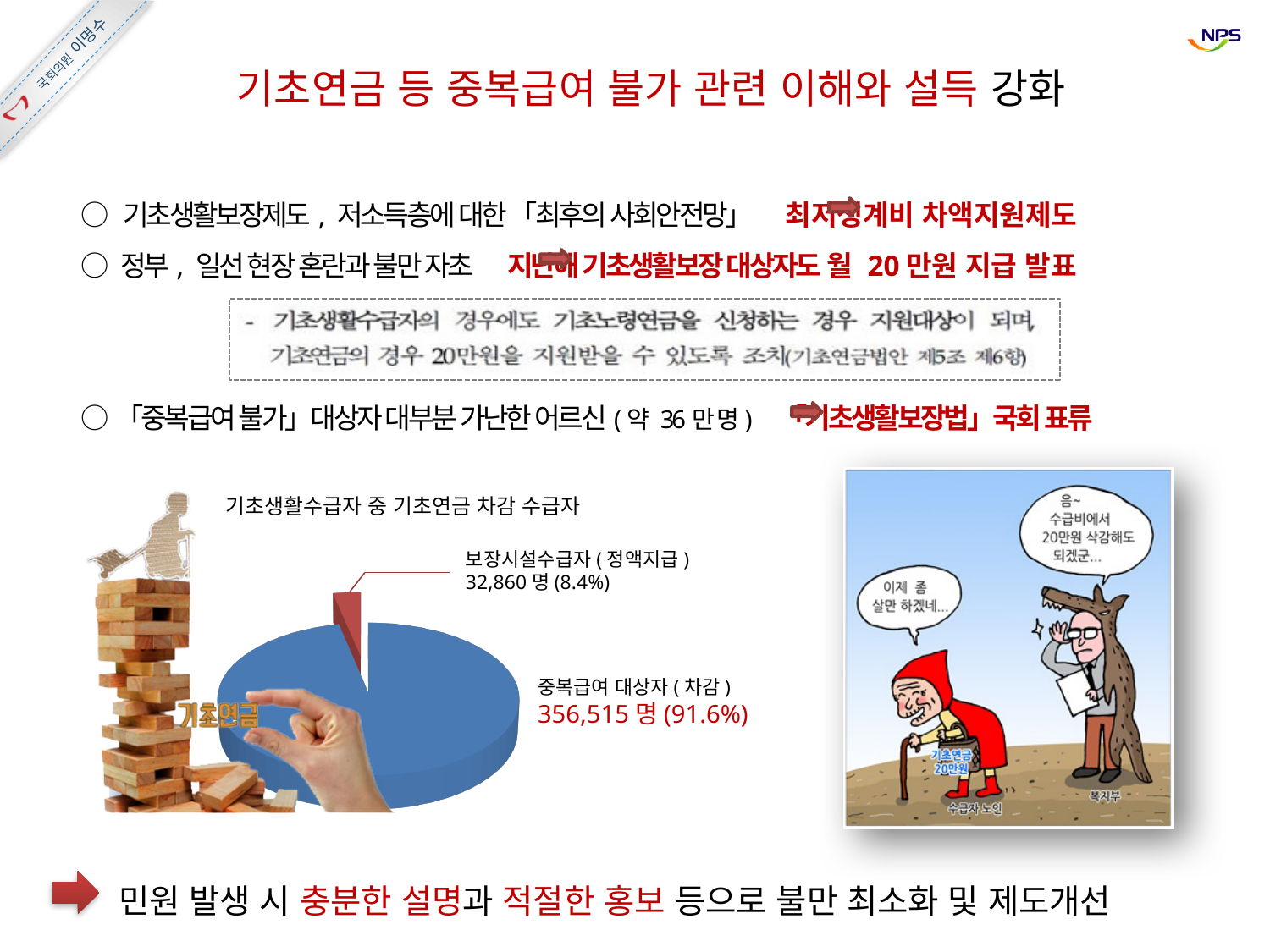
Which slice of the pie chart is the largest? 중복급여 대상자 (차감) What share of the pie does 중복급여 대상자 (차감) represent? 91.6% What share of the pie does 보장시설수급자 (정액지급) represent? 8.4% What is the total number of people across both slices of the pie chart? 389,375 명 How many people are in the 보장시설수급자 (정액지급) slice of the pie chart? 32,860 명 Which slice of the pie chart is the smallest? 보장시설수급자 (정액지급) Which slice has more people, 중복급여 대상자 (차감) or 보장시설수급자 (정액지급)? 중복급여 대상자 (차감) What is the title of the pie chart? 기초생활수급자 중 기초연금 차감 수급자 What kind of chart is shown on the slide? pie chart What is the difference in number of people between the 중복급여 대상자 (차감) slice and the 보장시설수급자 (정액지급) slice? 323,655 명 How many people are in the 중복급여 대상자 (차감) slice of the pie chart? 356,515 명 How many slices does the pie chart have? 2